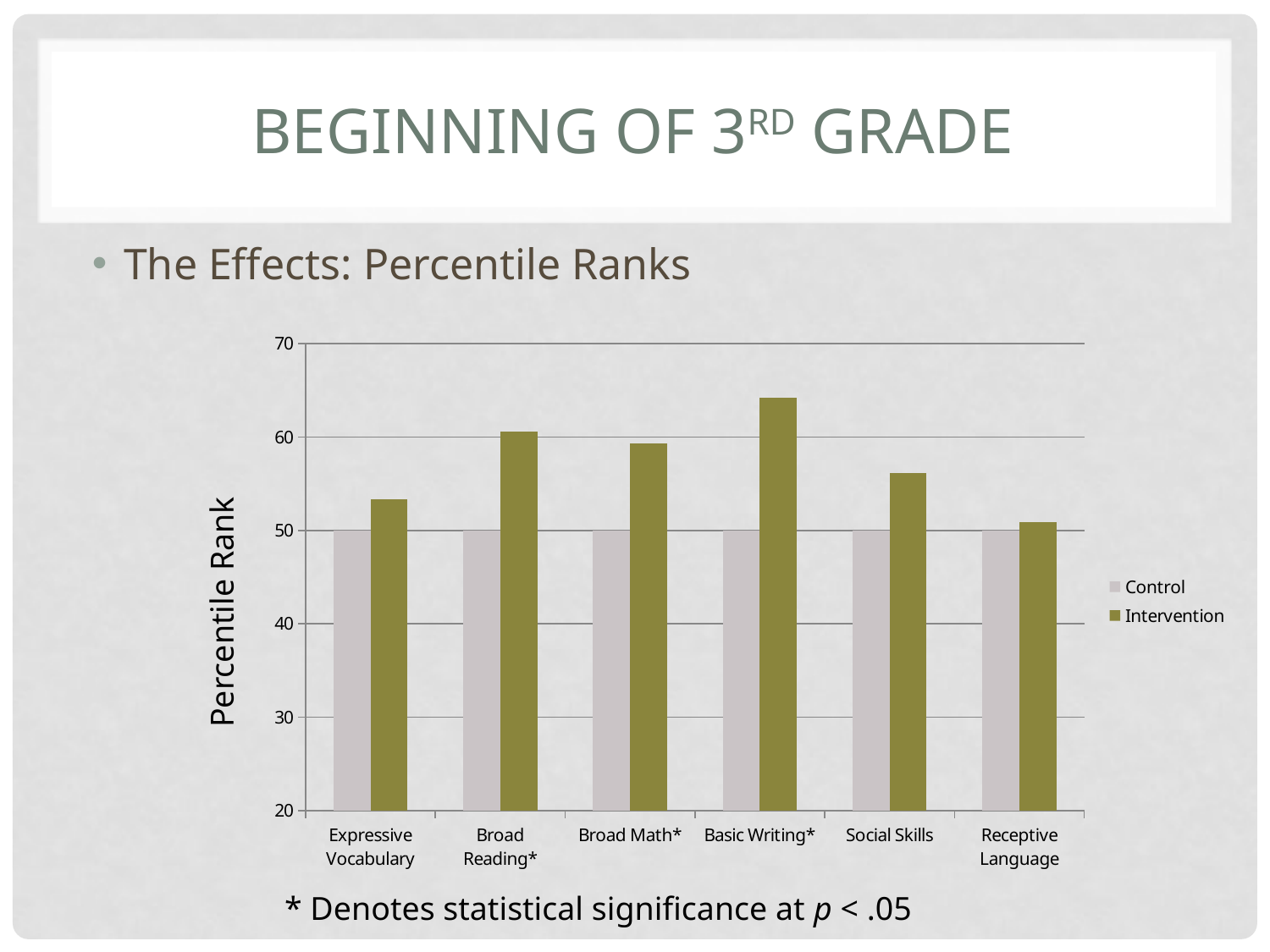
Is the Intervention value for Social Skills greater or less than 60? less Is the Intervention value for Expressive Vocabulary greater or less than 50? greater Which category has the lowest Intervention value? Receptive Language Which series is shown in the olive green colour? Intervention Is the Intervention value for Basic Writing* greater or less than 60? greater Which category has the highest Intervention value? Basic Writing* What is the Control value for Broad Math*? 50 What kind of chart is shown on the slide? Bar chart How many categories are shown along the x axis? 6 How many series does the legend list? 2 Which is larger, the Intervention value for Basic Writing* or for Social Skills? Basic Writing* What is the label on the vertical axis? Percentile Rank